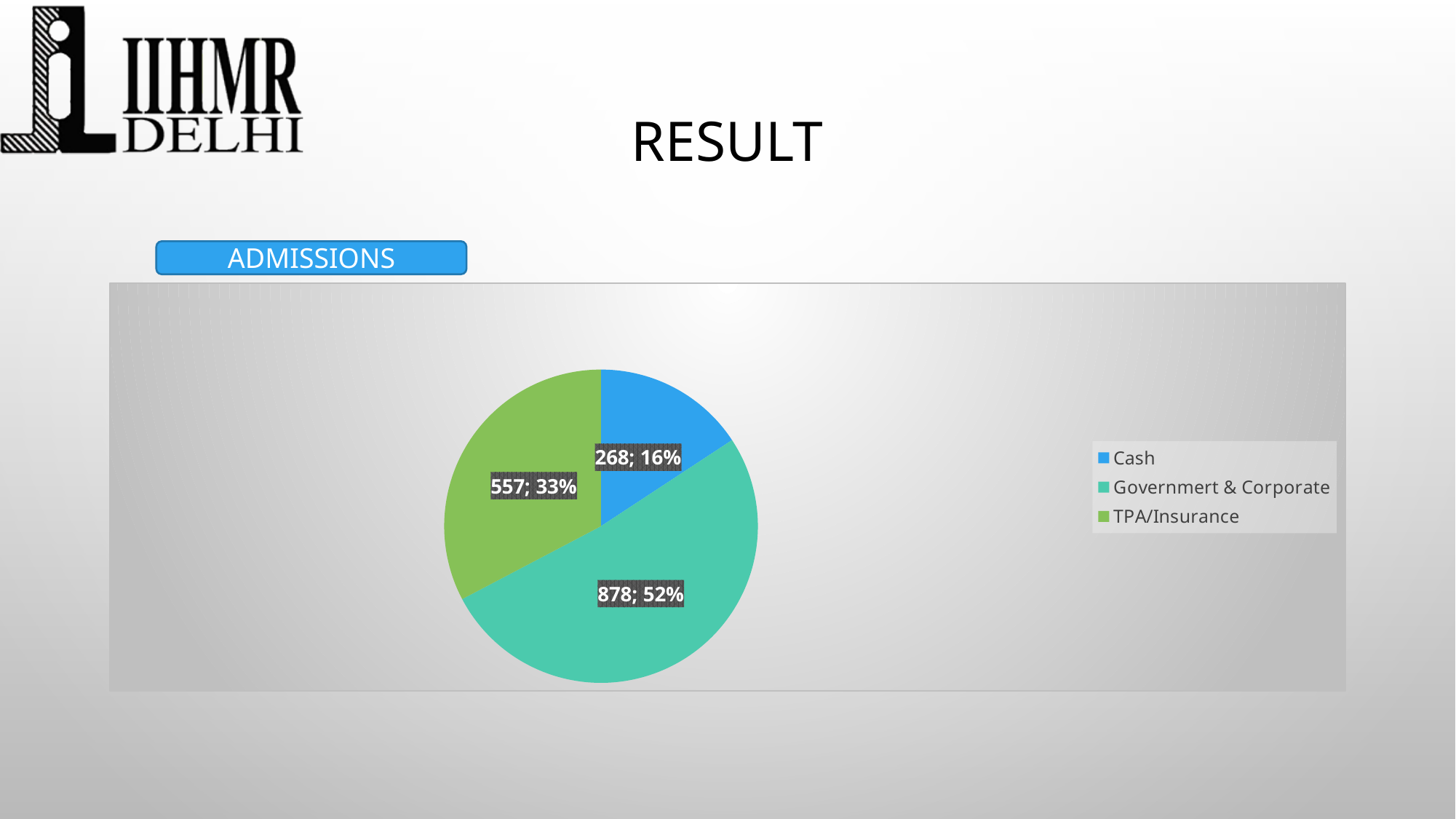
How many admissions are in the Cash category? 268 How many admissions are in the Government & Corporate category? 878 Which category has the lowest number of admissions? Cash Which has more admissions, TPA/Insurance or Cash? TPA/Insurance What percentage share of admissions does the TPA/Insurance slice represent? 33% What is the difference in admissions between Government & Corporate and TPA/Insurance? 321 What percentage share of admissions does the Cash slice represent? 16% How many categories does the legend list? 3 How many admissions are in the TPA/Insurance category? 557 What percentage share of admissions does the Government & Corporate slice represent? 52% Which category has the highest number of admissions? Government & Corporate What type of chart is shown on the slide? pie chart